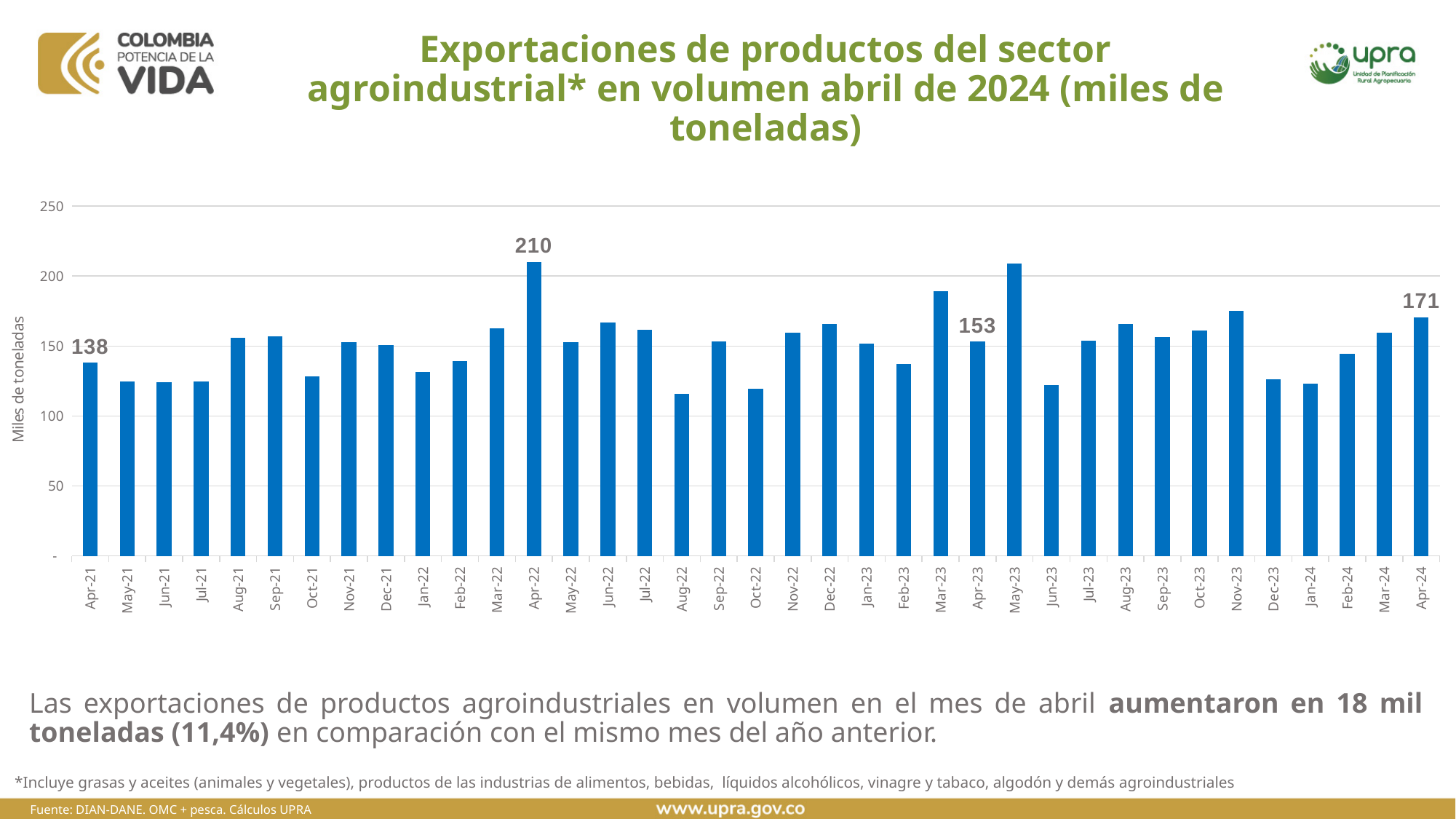
Is the value for Mar-23 greater or less than 150? greater What is the difference between the values for Apr-22 and Apr-21? 72 What is the value for Apr-22? 210 What kind of chart is shown on the slide? Bar chart What is the difference between the values for Apr-24 and Apr-23? 18 What is the label of the vertical axis? Miles de toneladas Is the value for Aug-22 greater or less than 150? less What is the value for Apr-24? 171 How many months (bars) are shown on the chart? 37 What is the value for Apr-21? 138 Which is larger, the value for Apr-22 or the value for Apr-24? Apr-22 What is the value for Apr-23? 153